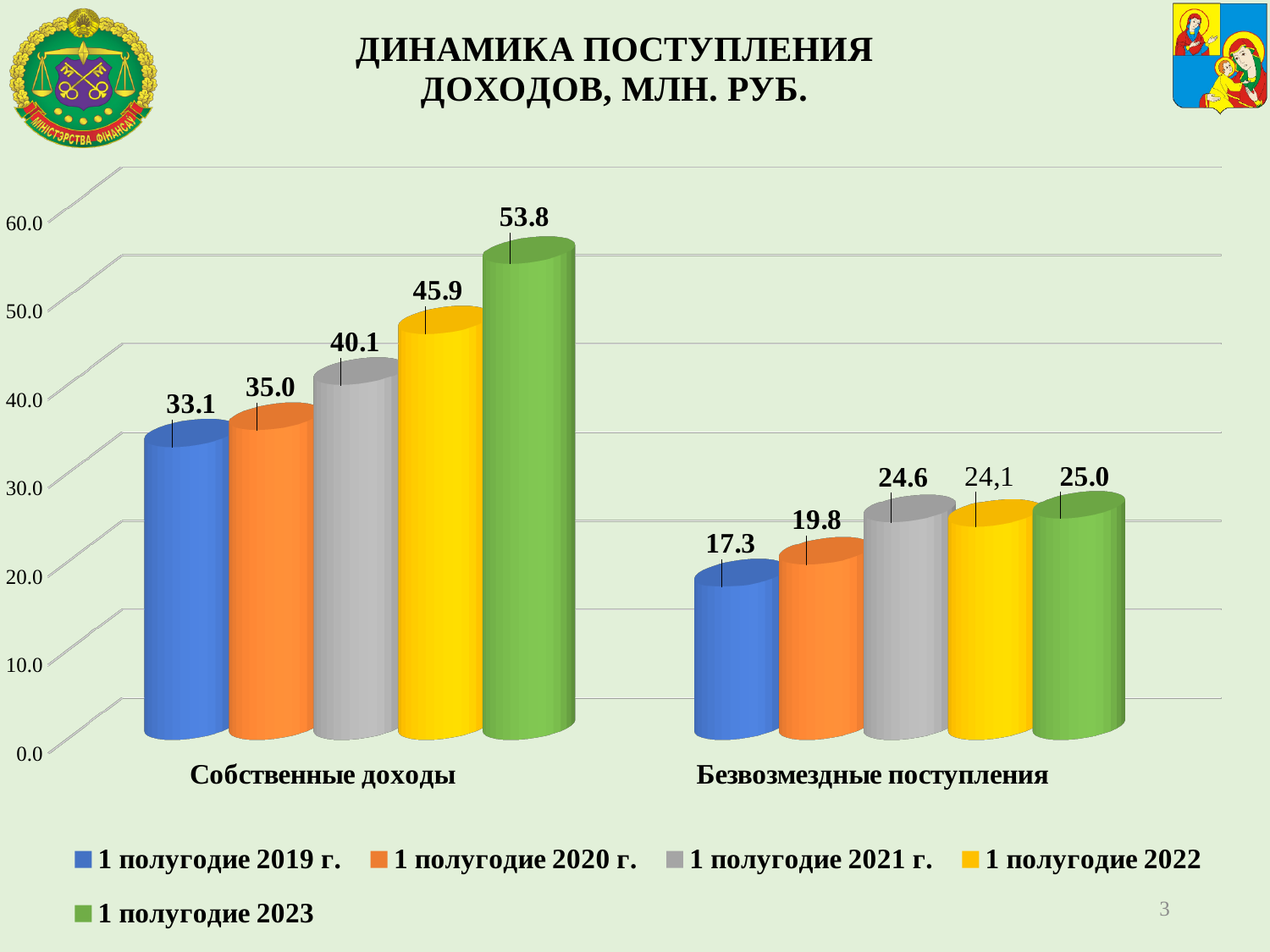
What is the value for Безвозмездные поступления in 1 полугодие 2022? 24,1 How many series does the legend list? 5 What is the value for Безвозмездные поступления in 1 полугодие 2023? 25.0 What is the title of the chart? ДИНАМИКА ПОСТУПЛЕНИЯ ДОХОДОВ, МЛН. РУБ. What is the value for Собственные доходы in 1 полугодие 2019 г.? 33.1 How many categories are shown on the x axis? 2 Which is larger: Безвозмездные поступления in 1 полугодие 2021 г. or in 1 полугодие 2022? 1 полугодие 2021 г. What is the value for Собственные доходы in 1 полугодие 2021 г.? 40.1 What kind of chart is shown on the slide? Bar chart Which series has the highest value for Собственные доходы? 1 полугодие 2023 What is the difference between the Собственные доходы values for 1 полугодие 2023 and 1 полугодие 2022? 7.9 Which series has the lowest value for Безвозмездные поступления? 1 полугодие 2019 г.